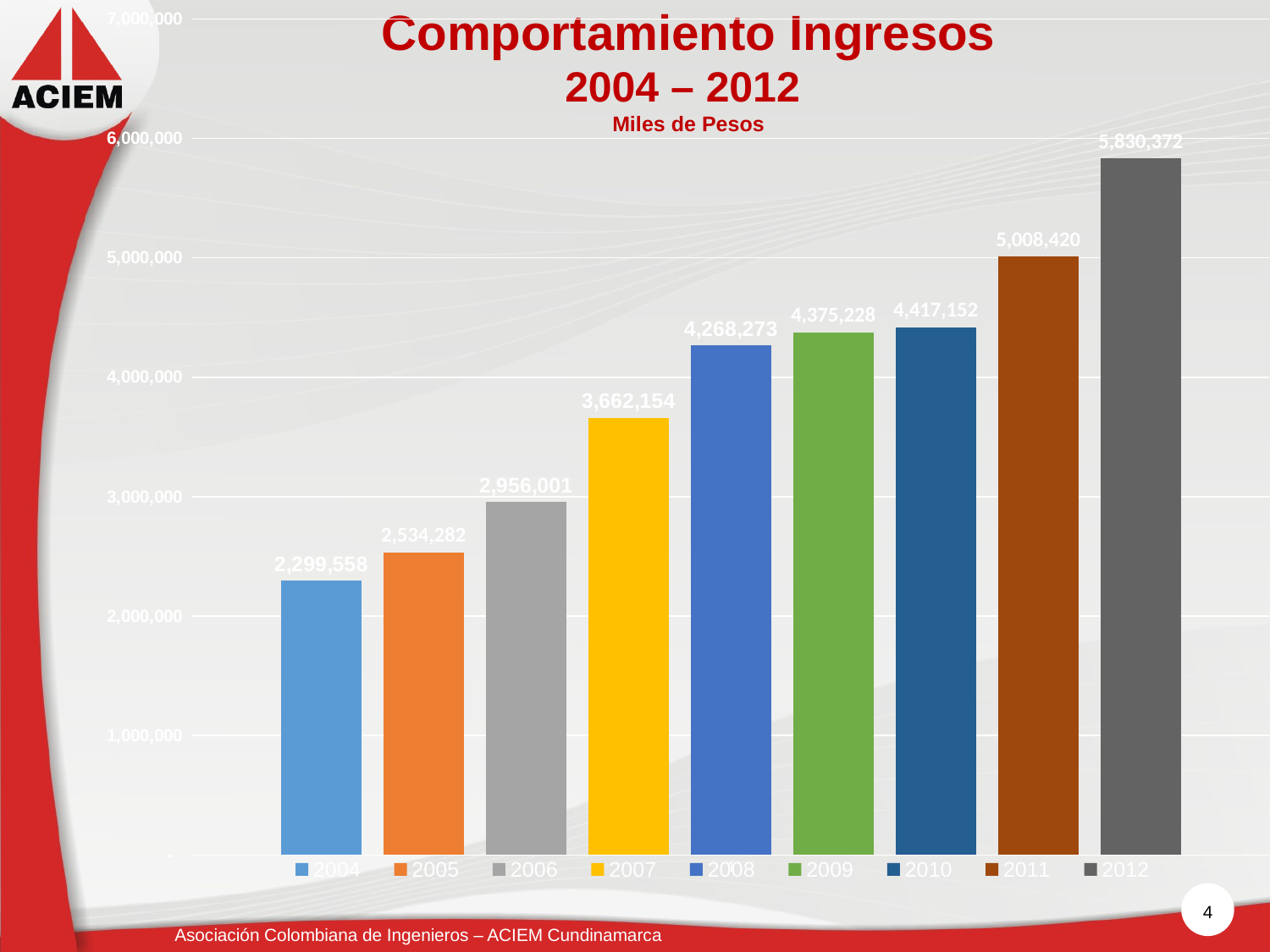
Which year has the highest value? 2012 What kind of chart is shown on the slide? bar chart What is the value for 2011? 5,008,420 What is the value for 2004? 2,299,558 What is the difference between the values for 2005 and 2004? 234,724 Do the values rise or fall from 2004 to 2012? rise Is the value for 2006 greater or less than 3,000,000? less Which is larger, the value for 2008 or the value for 2011? 2011 Which year has the lowest value? 2004 What is the difference between the values for 2012 and 2011? 821,952 How many years are shown in the chart? 9 What is the value for 2007? 3,662,154